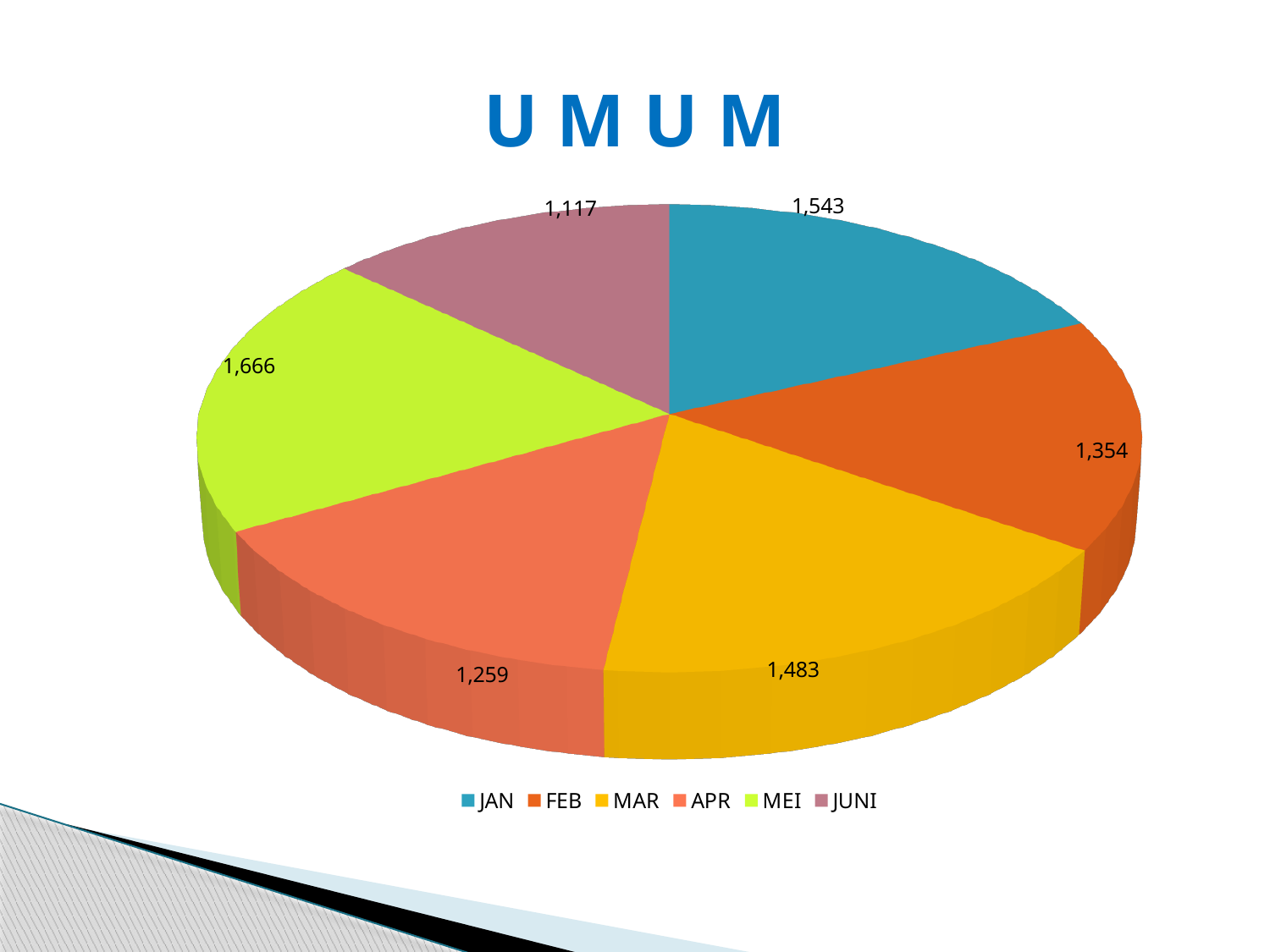
Which is larger, the value for MAR or the value for FEB? MAR What is the value for JUNI? 1,117 What is the title of the chart? U M U M What is the difference between the values for JAN and APR? 284 What type of chart is shown on the slide? Pie chart What is the value for MEI? 1,666 Which month has the smallest slice? JUNI Which month has the largest slice? MEI How many slices does the pie chart have? 6 What is the difference between the values for MEI and JUNI? 549 What is the value for FEB? 1,354 What is the total of all the slices in the pie chart? 8,422